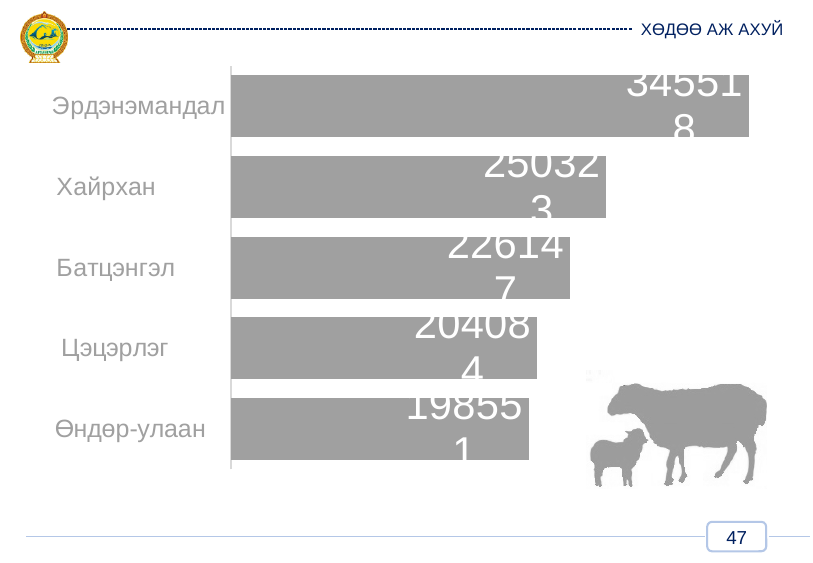
What is the value for Эрдэнэмандал? 345518 What is the difference between the values for Эрдэнэмандал and Хайрхан? 95195 What kind of chart is shown on the slide? bar chart What is the value for Хайрхан? 250323 What is the value for Өндөр-улаан? 198551 Which category has the lowest value? Өндөр-улаан Which category has the highest value? Эрдэнэмандал How many categories are shown in the chart? 5 What is the value for Батцэнгэл? 226147 What is the value for Цэцэрлэг? 204084 Which is larger, the value for Батцэнгэл or the value for Цэцэрлэг? Батцэнгэл What is the difference between the values for Хайрхан and Батцэнгэл? 24176